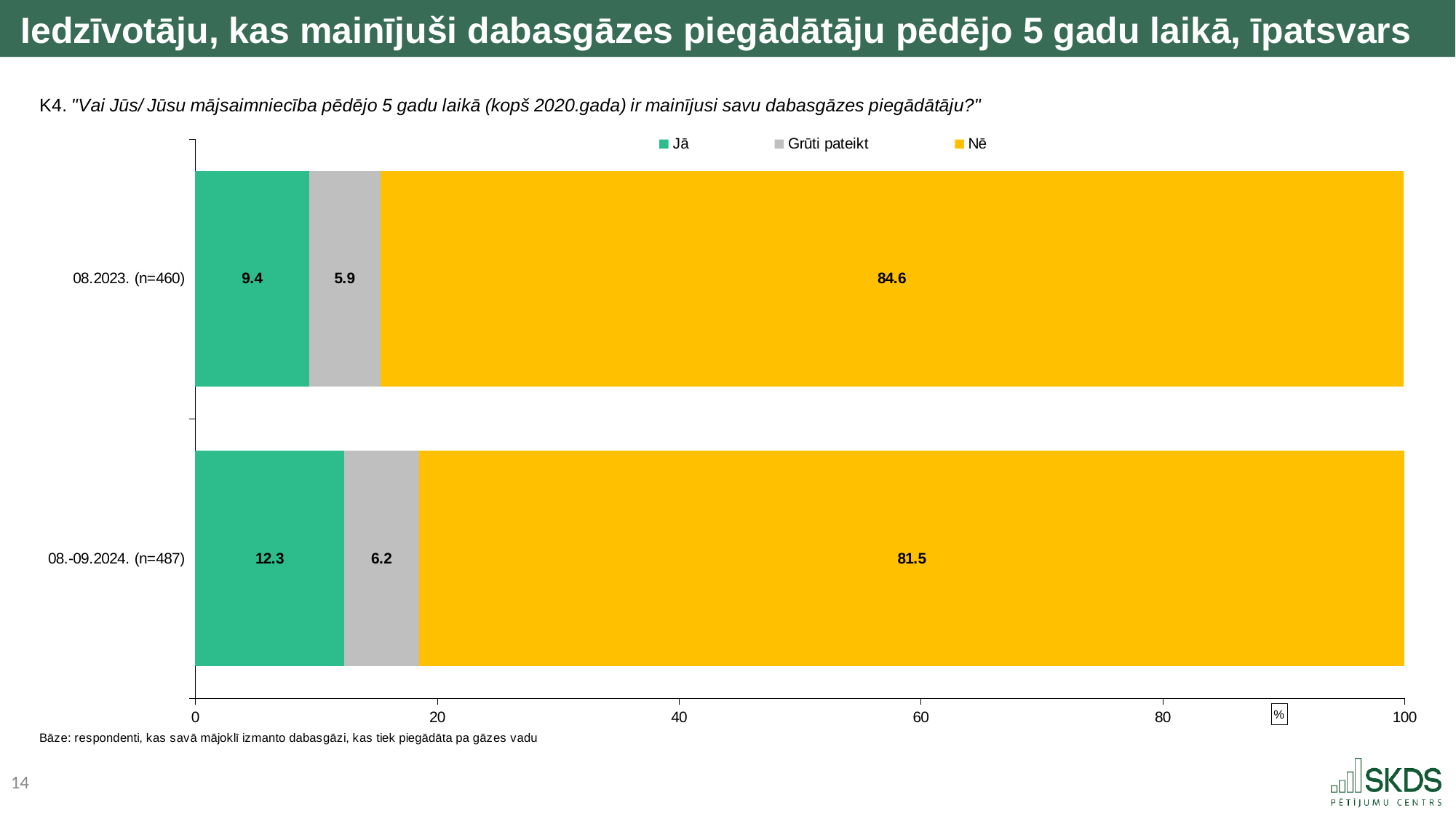
Is the "Grūti pateikt" value larger in 08.2023. (n=460) or in 08.-09.2024. (n=487)? 08.-09.2024. (n=487) Which colour represents "Nē" in the chart? Yellow What is the difference between the "Nē" values for 08.2023. (n=460) and 08.-09.2024. (n=487)? 3.1 Which period has the lower value for "Nē"? 08.-09.2024. (n=487) Which period has the higher value for "Jā"? 08.-09.2024. (n=487) What is the value for "Grūti pateikt" in 08.2023. (n=460)? 5.9 What is the value for "Nē" in 08.-09.2024. (n=487)? 81.5 How many periods (categories) are shown on the chart? 2 What is the value for "Jā" in 08.-09.2024. (n=487)? 12.3 What kind of chart is shown on the slide? Stacked bar chart What is the value for "Jā" in 08.2023. (n=460)? 9.4 How many series does the legend list? 3